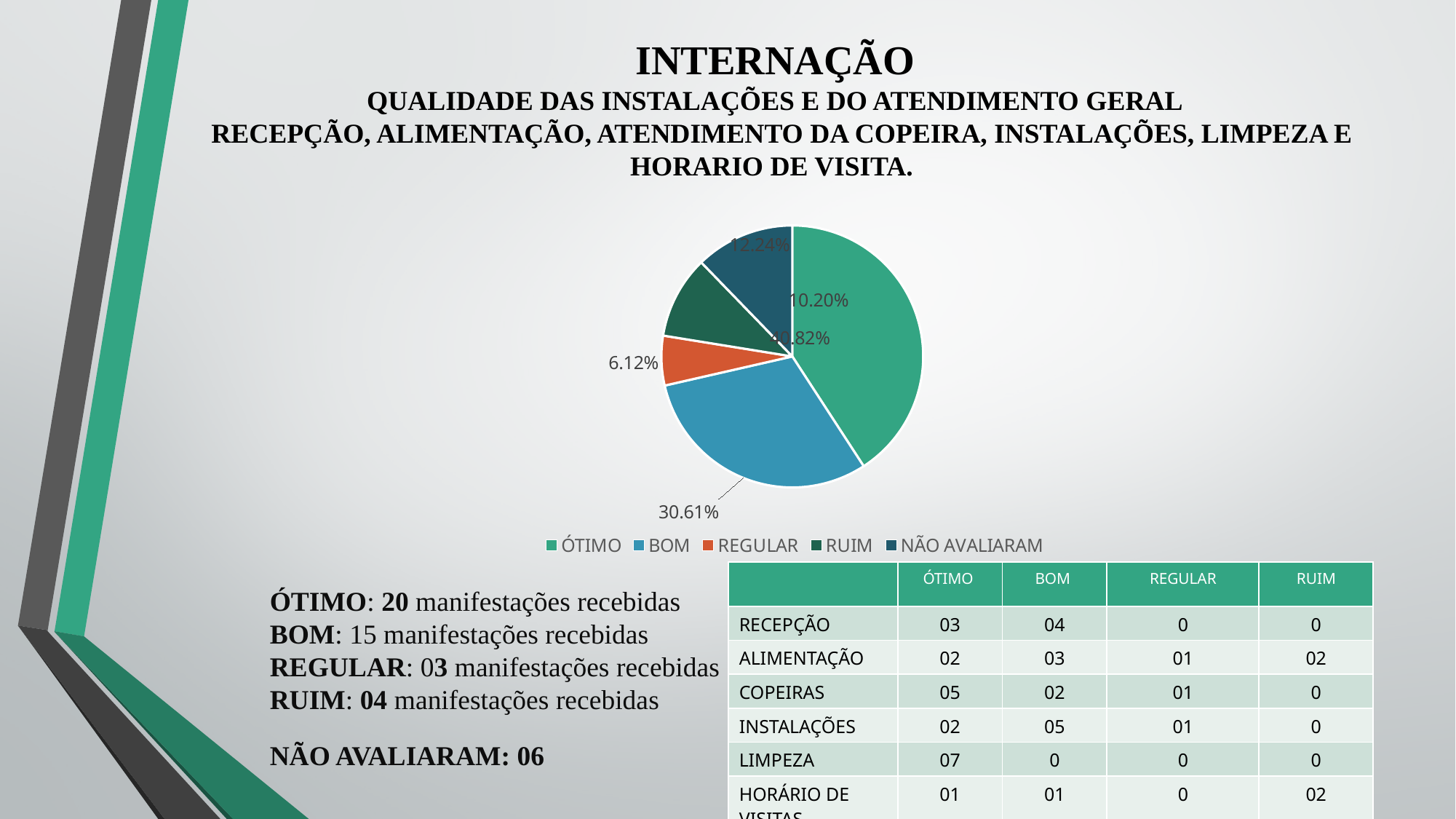
Which colour represents REGULAR in the pie chart's legend? orange Which category has the smallest slice in the pie chart? REGULAR What is the difference in percentage points between the NÃO AVALIARAM slice and the REGULAR slice? 6.12 Which category has the largest slice in the pie chart? ÓTIMO How many entries does the pie chart's legend list? 5 Which slice is larger in the pie chart, RUIM or NÃO AVALIARAM? NÃO AVALIARAM What percentage is shown for RUIM in the pie chart? 10.20% What kind of chart is shown on the slide? pie chart What percentage is shown for NÃO AVALIARAM in the pie chart? 12.24% What percentage is shown for BOM in the pie chart? 30.61% How many slices does the pie chart have? 5 What percentage is shown for REGULAR in the pie chart? 6.12%